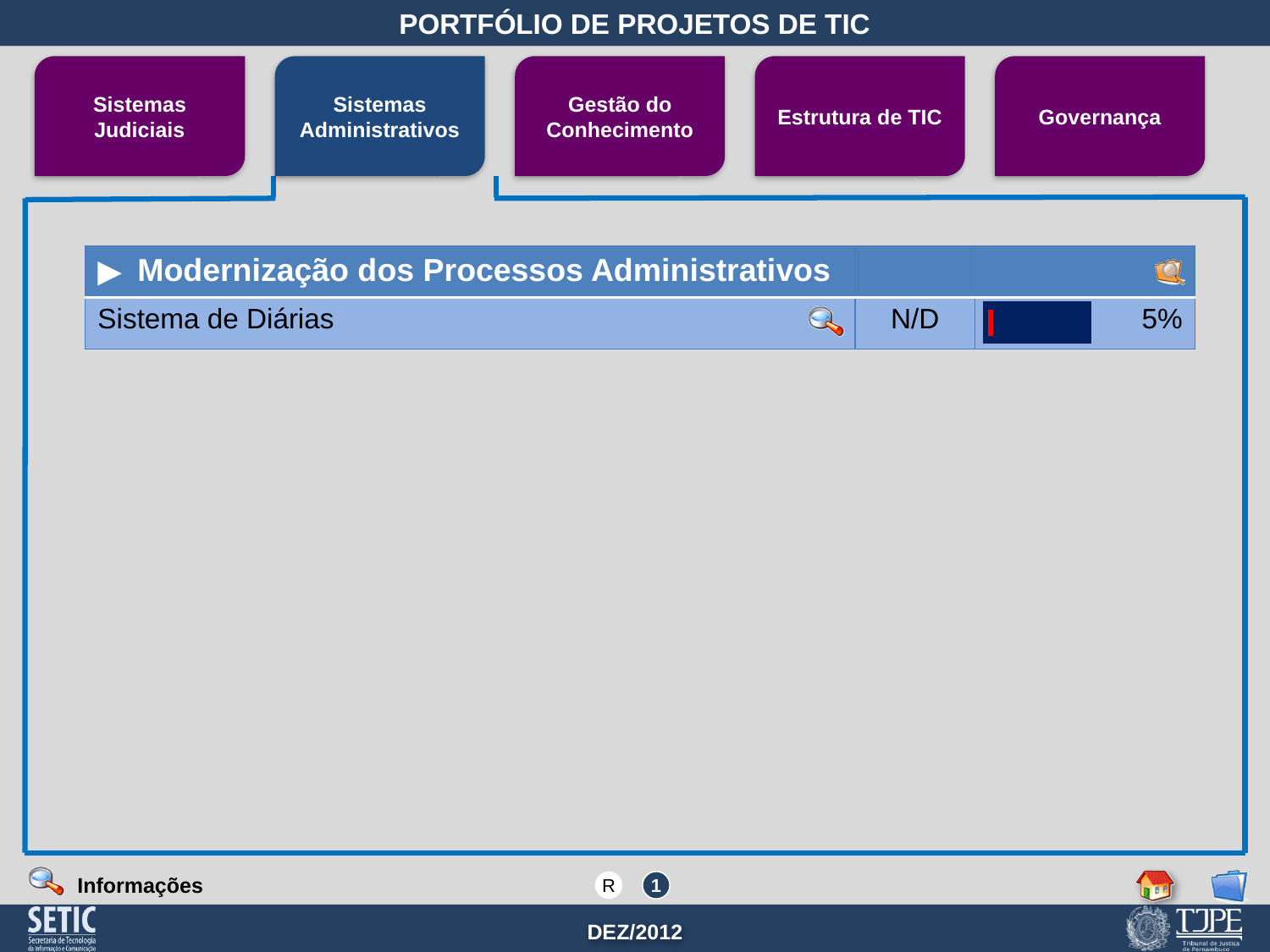
What value is shown in the column to the left of the progress bar for Sistema de Diárias? N/D What kind of chart is used to show the progress of Sistema de Diárias? bar chart What completion percentage is shown for Sistema de Diárias? 5% Which tab is highlighted in blue at the top of the slide? Sistemas Administrativos What is the name of the project group heading above Sistema de Diárias? Modernização dos Processos Administrativos How many projects are listed under Modernização dos Processos Administrativos? 1